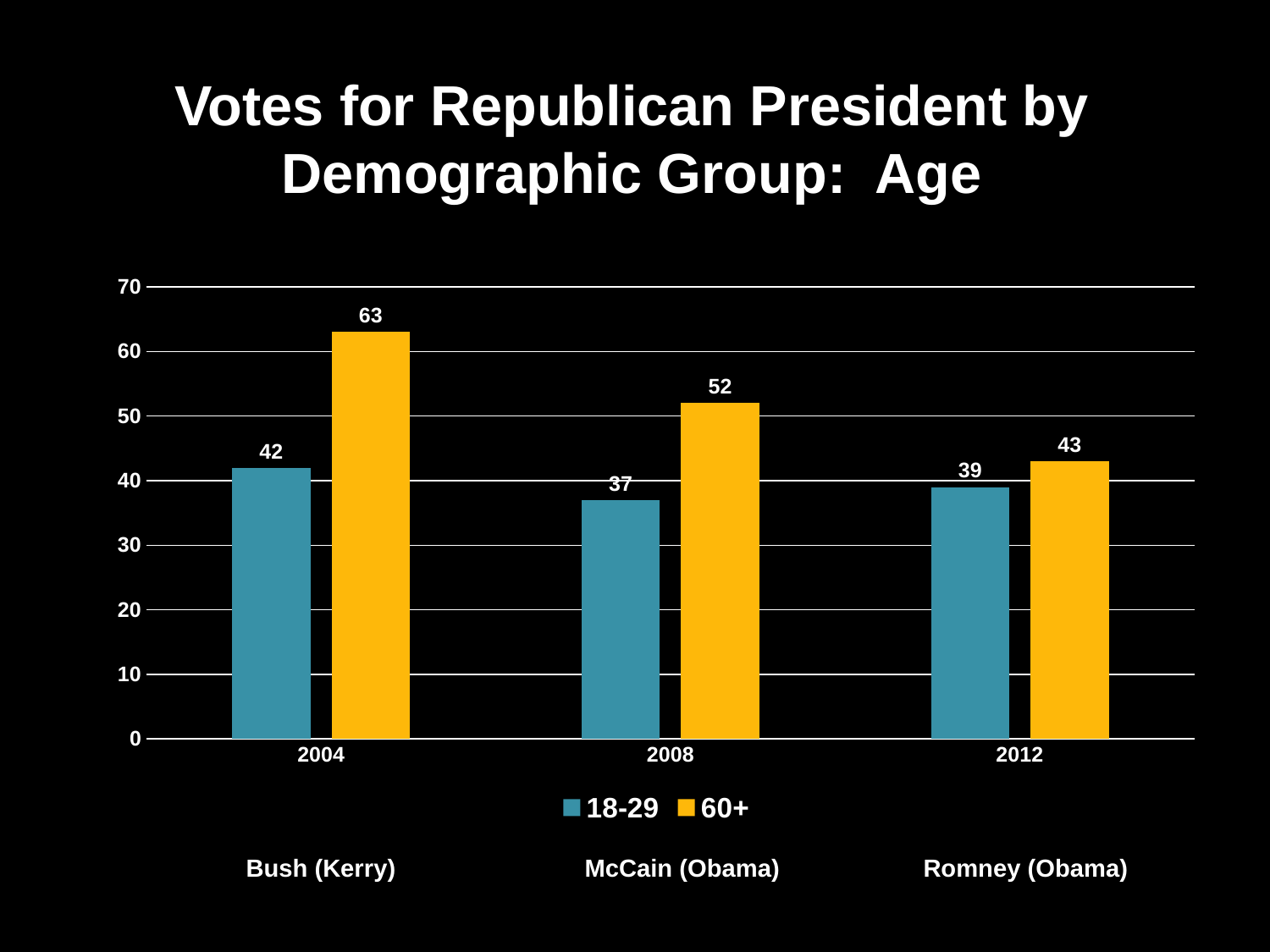
What is the difference between the 60+ value in 2004 and the 60+ value in 2012? 20 What kind of chart is shown on the slide? Bar chart Does the 60+ series rise or fall from 2004 to 2012? Fall How many series does the legend list? 2 How many years are shown on the x axis? 3 What is the value for the 18-29 series in 2004? 42 What is the value for the 60+ series in 2008? 52 Which is larger in 2012, the 18-29 value or the 60+ value? 60+ What is the value for the 18-29 series in 2012? 39 What is the difference between the 60+ and 18-29 values in 2004? 21 In which year is the 60+ series highest? 2004 In which year is the 18-29 series lowest? 2008